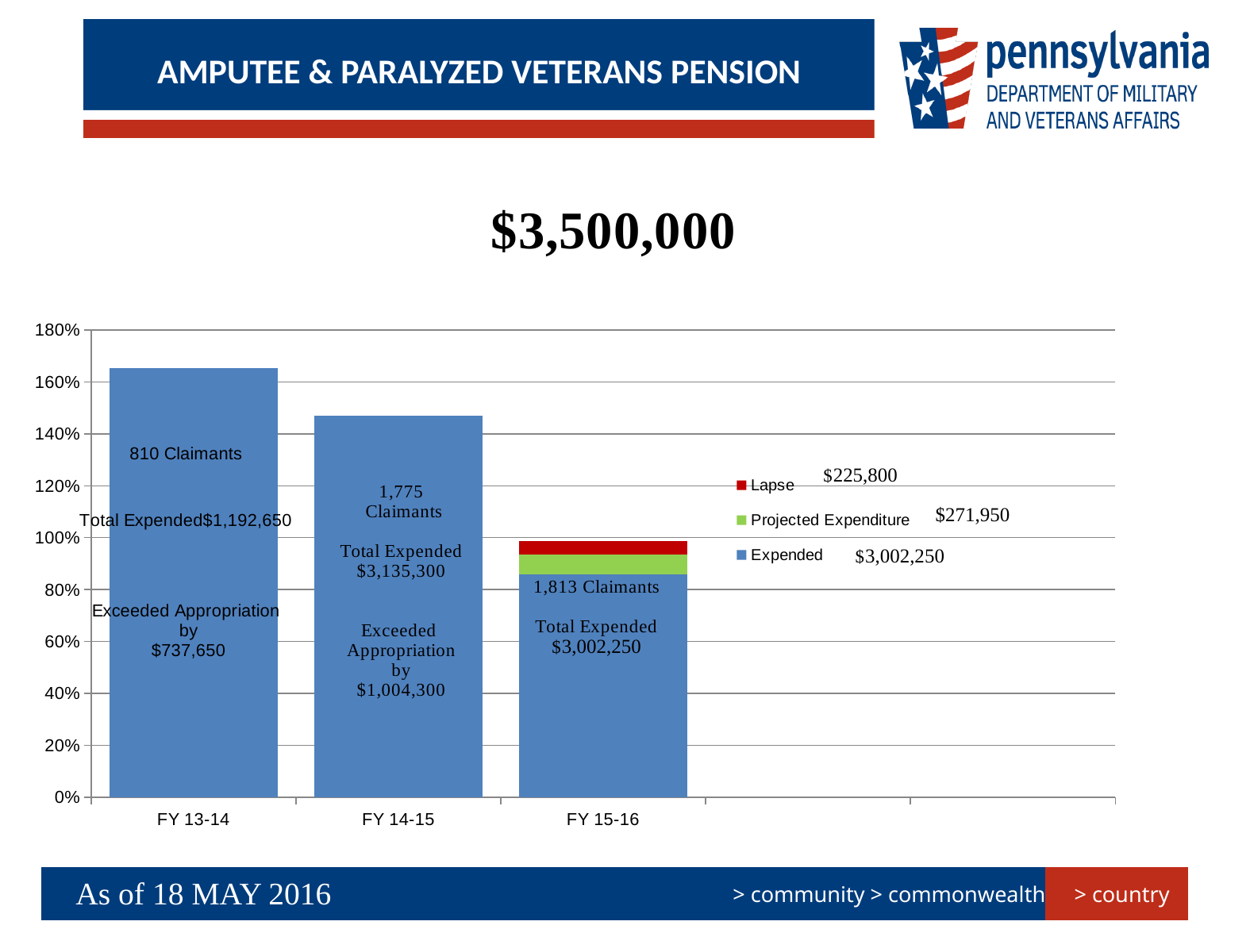
How many series does the chart legend list? 3 Which fiscal year has the tallest bar in the chart? FY 13-14 What is the difference in claimants between FY 15-16 and FY 14-15? 38 How many fiscal years are shown on the x axis of the chart? 3 What is the total of the stacked bar for FY 15-16 (Expended + Projected Expenditure + Lapse)? $3,500,000 By how much did FY 14-15 exceed its appropriation? $1,004,300 What is the Projected Expenditure value shown in the legend? $271,950 How many claimants are shown for FY 13-14? 810 Claimants What type of chart is shown on the slide? bar chart What is the Total Expended shown for FY 14-15? $3,135,300 Which fiscal year has the lowest Expended bar? FY 15-16 Is the Expended bar for FY 15-16 greater or less than 100%? less